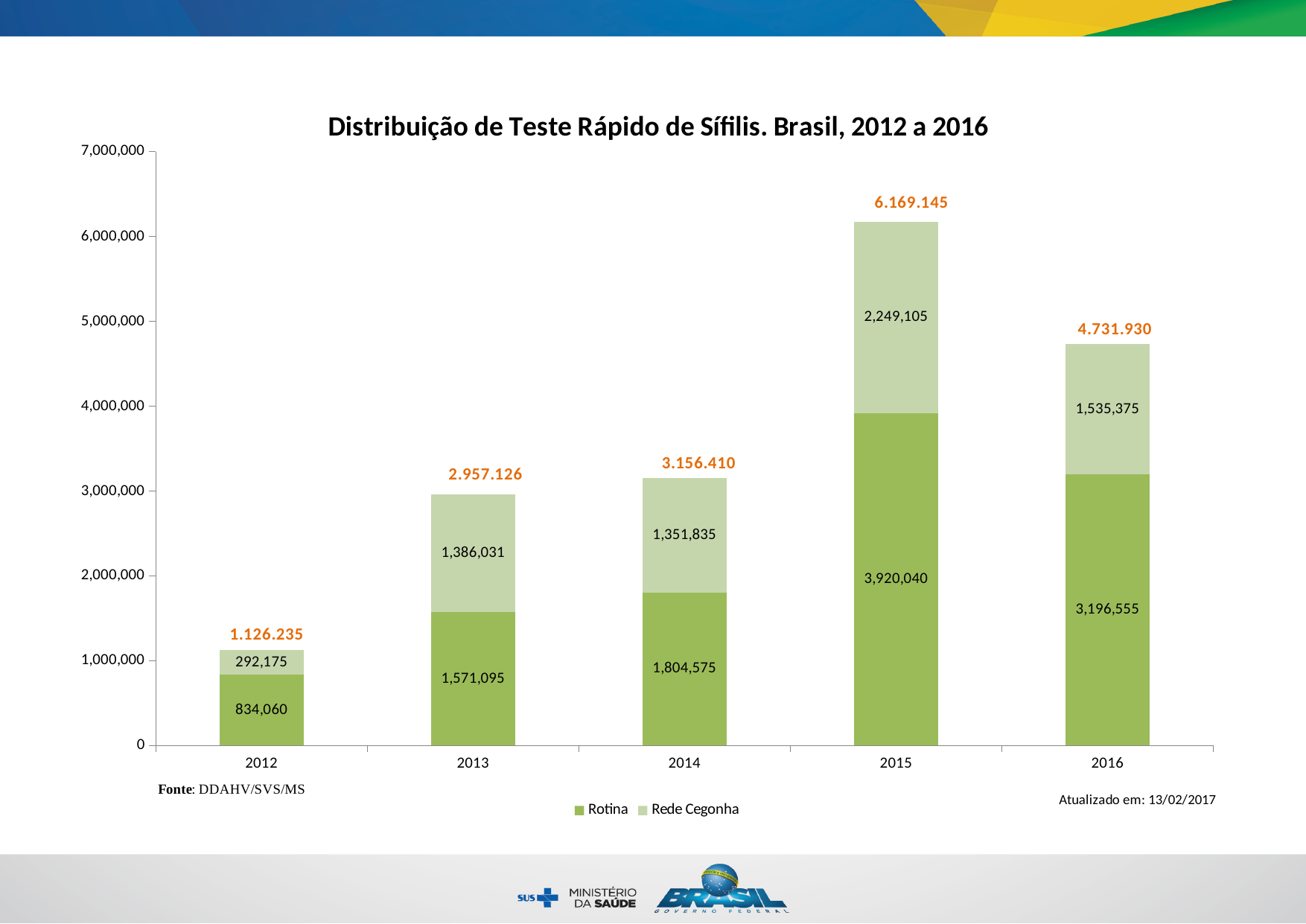
What is the Rotina value for 2015? 3,920,040 What is the total of the stacked bar for 2014, as printed above it? 3.156.410 Which year has the highest total stacked bar? 2015 What is the Rotina value for 2012? 834,060 What is the Rede Cegonha value for 2013? 1,386,031 Which year has the lowest Rede Cegonha value? 2012 How many years are shown on the x axis? 5 What is the difference between the Rotina values for 2016 and 2014? 1,391,980 What is the difference between the Rede Cegonha values for 2015 and 2016? 713,730 What kind of chart is shown on the slide? Stacked bar chart How many series does the legend list? 2 In 2013, which is larger: the Rotina value or the Rede Cegonha value? Rotina